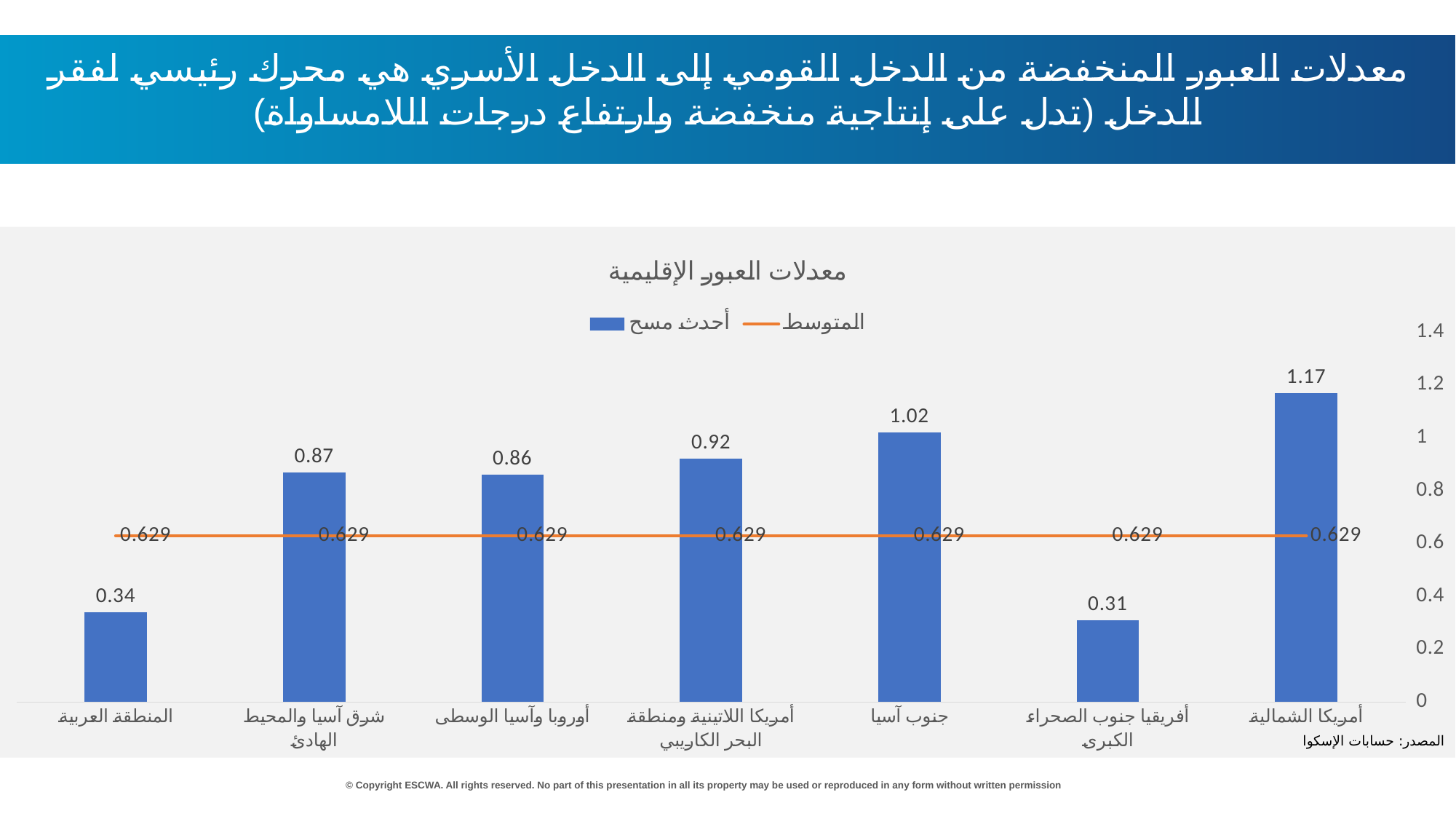
What is the value of the 'أحدث مسح' bar for 'المنطقة العربية' (Arab region)? 0.34 What is the title of the chart? معدلات العبور الإقليمية What is the difference between the 'أحدث مسح' values for 'أمريكا الشمالية' and 'المنطقة العربية'? 0.83 Which region has the highest 'أحدث مسح' value? أمريكا الشمالية What is the value of the 'أحدث مسح' bar for 'أمريكا الشمالية' (North America)? 1.17 Which region has the lowest 'أحدث مسح' value? أفريقيا جنوب الصحراء الكبرى Is the 'أحدث مسح' value for 'أمريكا اللاتينية ومنطقة البحر الكاريبي' greater or less than 0.8? greater What is the value of the 'أحدث مسح' bar for 'جنوب آسيا' (South Asia)? 1.02 How many series does the chart legend list? 2 What value does the 'المتوسط' (average) line show? 0.629 How many regions are shown on the x axis of the chart? 7 Which has a larger 'أحدث مسح' value: 'جنوب آسيا' or 'أوروبا وآسيا الوسطى'? جنوب آسيا